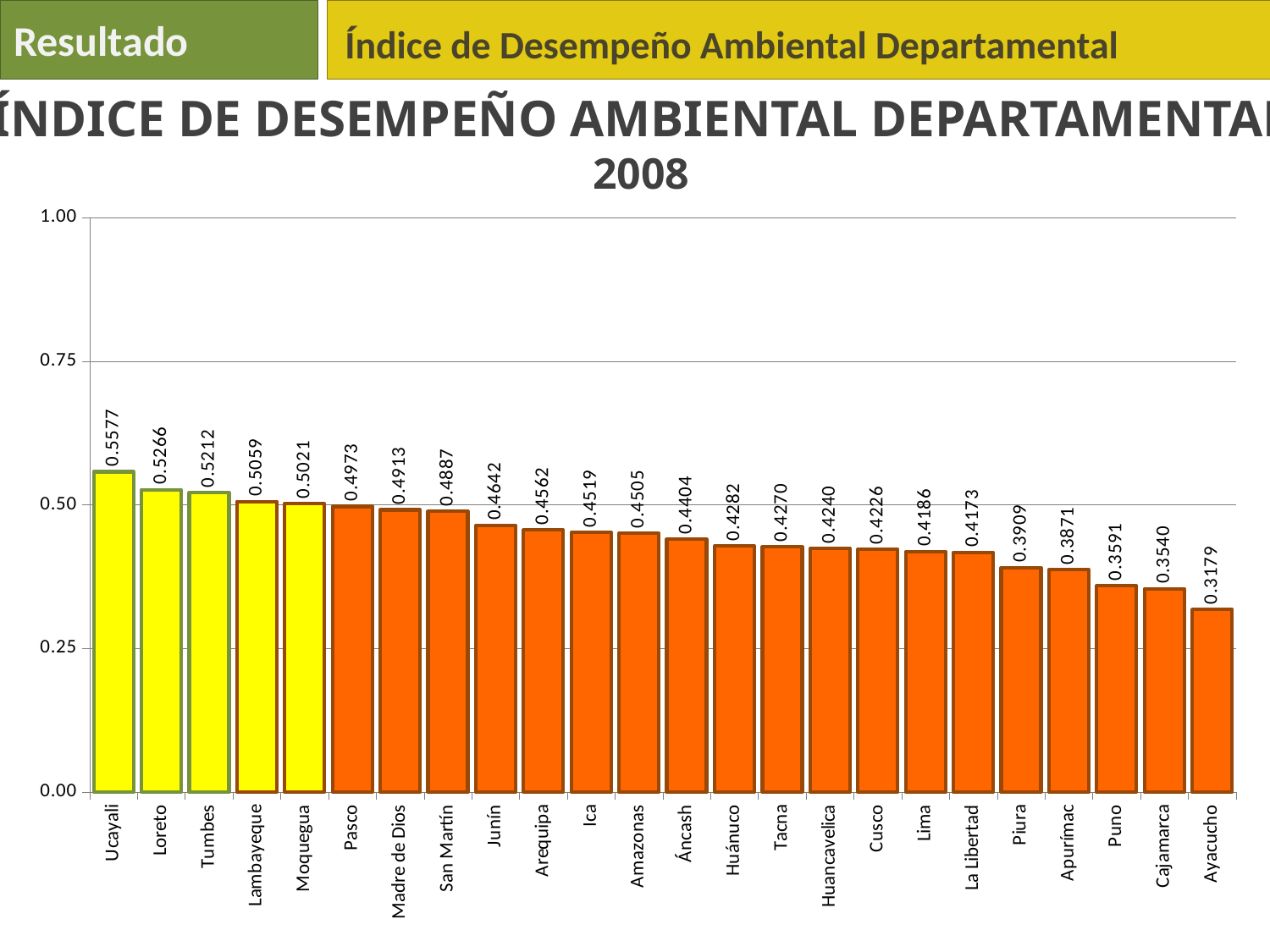
Do the values rise or fall from left to right along the x axis? fall Which department has the lowest value? Ayacucho Which department has the highest value? Ucayali What is the value for Madre de Dios? 0.4913 What kind of chart is shown on the slide? bar chart What is the difference between the values for Ucayali and Ayacucho? 0.2398 What is the value for Cusco? 0.4226 Which is larger, the value for Pasco or the value for Puno? Pasco How many departments are shown on the chart? 24 What is the difference between the values for Lima and Piura? 0.0277 Is the value for Tumbes greater or less than 0.50? greater What is the value for Ucayali? 0.5577